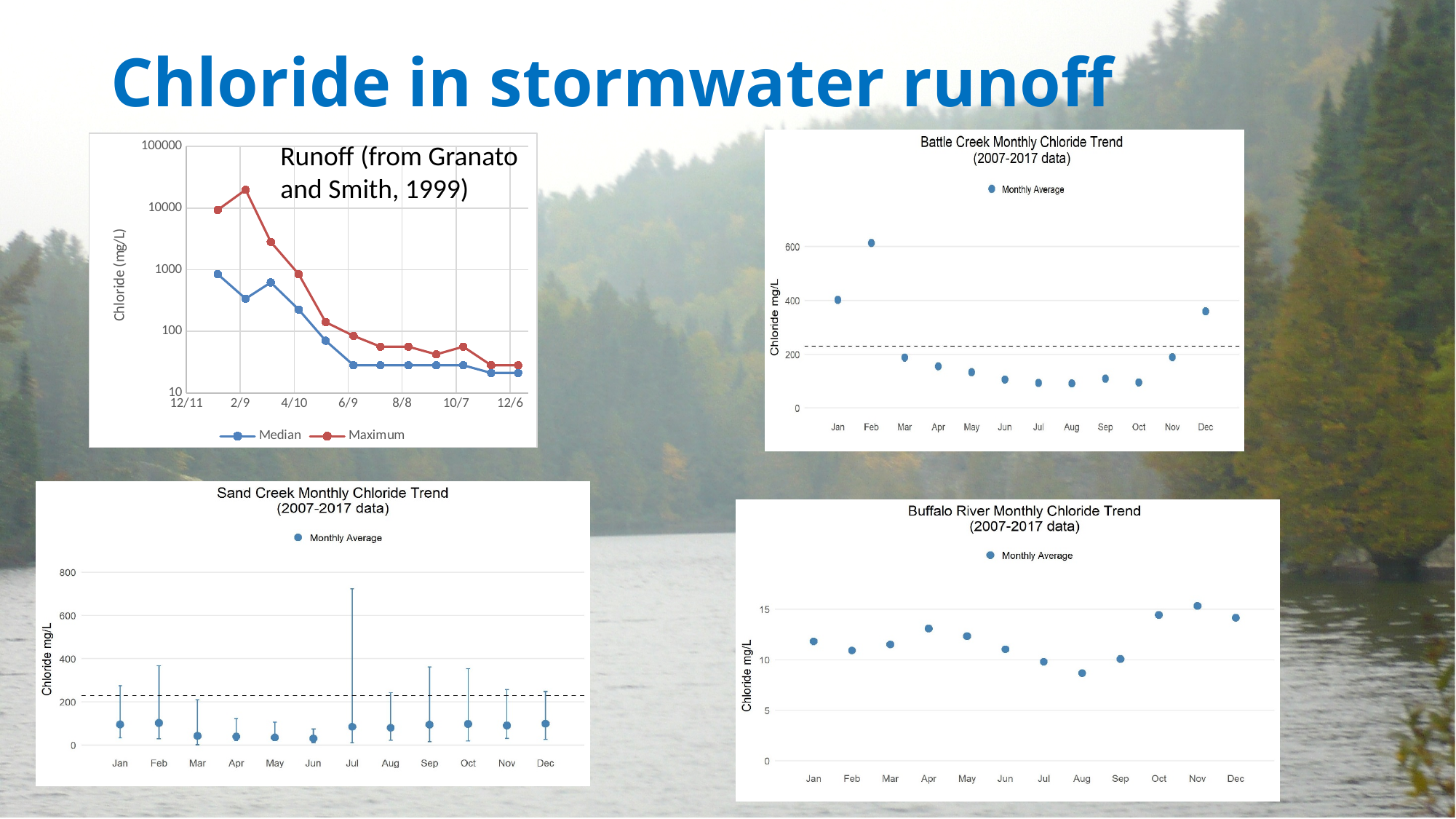
In the 'Battle Creek Monthly Chloride Trend' chart, which month has the highest monthly average? Feb In the 'Buffalo River Monthly Chloride Trend' chart, which month has the lowest monthly average? Aug What kind of chart is the 'Runoff (from Granato and Smith, 1999)' chart? line chart How many series does the legend of the 'Runoff (from Granato and Smith, 1999)' chart list? 2 How many months are plotted in the 'Sand Creek Monthly Chloride Trend' chart? 12 In the 'Runoff (from Granato and Smith, 1999)' chart, which series is higher at 2/9, Median or Maximum? Maximum In the 'Battle Creek Monthly Chloride Trend' chart, is the value for Dec greater or less than 400? less In the 'Buffalo River Monthly Chloride Trend' chart, is the value for Aug greater or less than 10? less In the 'Sand Creek Monthly Chloride Trend' chart, is the value for Jan greater or less than 200? less In the 'Buffalo River Monthly Chloride Trend' chart, which month has the highest monthly average? Nov In the 'Runoff (from Granato and Smith, 1999)' chart, do the Median values generally rise or fall from 12/11 to 12/6? fall